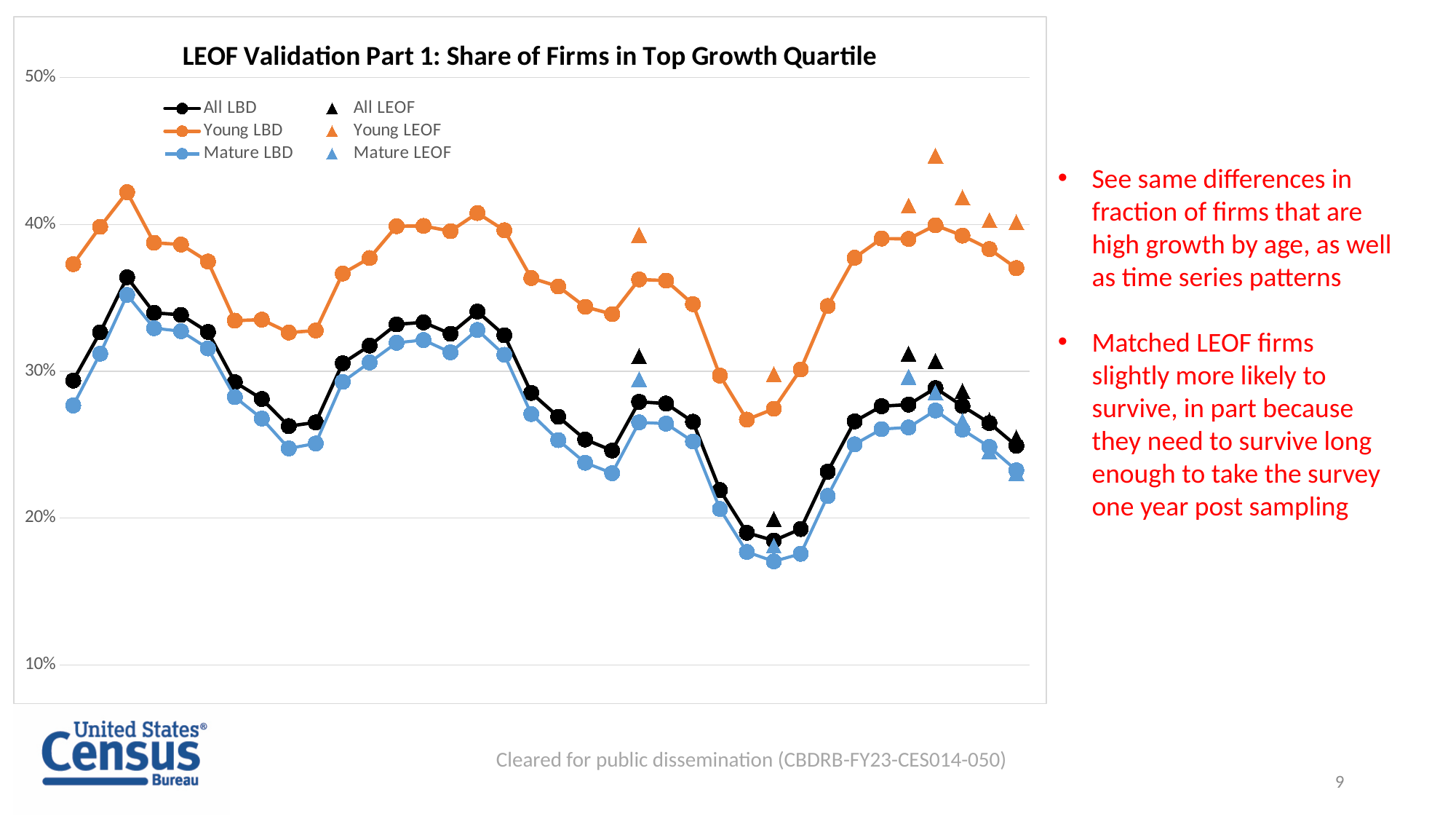
What is the title of the chart? LEOF Validation Part 1: Share of Firms in Top Growth Quartile Is the first point of the Mature LBD series greater or less than 30%? less What kind of chart is shown on the slide? Line chart Which of the three LBD series lies highest across the whole chart? Young LBD How many series does the chart's legend list? 6 Which colour is used for the Young LBD and Young LEOF series? Orange Which series reaches the single lowest value on the chart? Mature LBD Which of the three LBD series lies lowest across the whole chart? Mature LBD Which series reaches the single highest value on the chart? Young LEOF Is the peak value of the Young LBD series greater or less than 40%? greater Is the lowest value of the All LBD series greater or less than 20%? less Does the All LBD series end higher or lower than it begins? lower